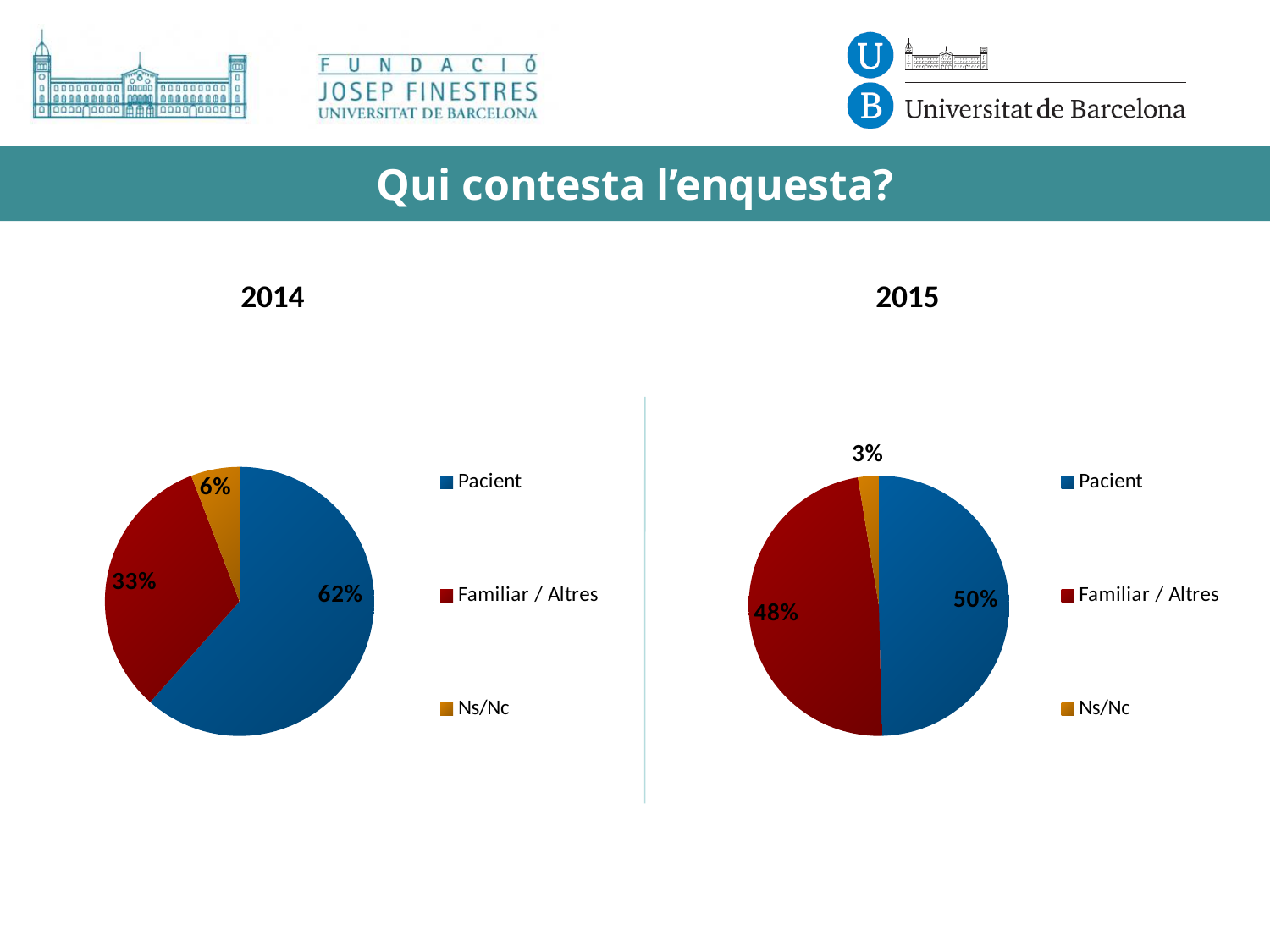
In the 2015 pie chart, what share is Ns/Nc? 3% How many entries does the legend of the 2014 chart list? 3 In the 2014 pie chart, what share of respondents is Pacient? 62% In the 2014 pie chart, what is the difference between the Pacient and Familiar / Altres shares? 29% In the 2014 pie chart, which is larger: Familiar / Altres or Ns/Nc? Familiar / Altres In the 2015 pie chart, what share of respondents is Pacient? 50% What type of chart is used for the 2015 data? Pie chart In the 2015 pie chart, which category has the smallest share? Ns/Nc In the 2015 pie chart, what share is Familiar / Altres? 48% In the 2014 pie chart, which category has the largest share? Pacient In the 2014 pie chart, what share is Ns/Nc? 6% In the 2014 pie chart, what share is Familiar / Altres? 33%